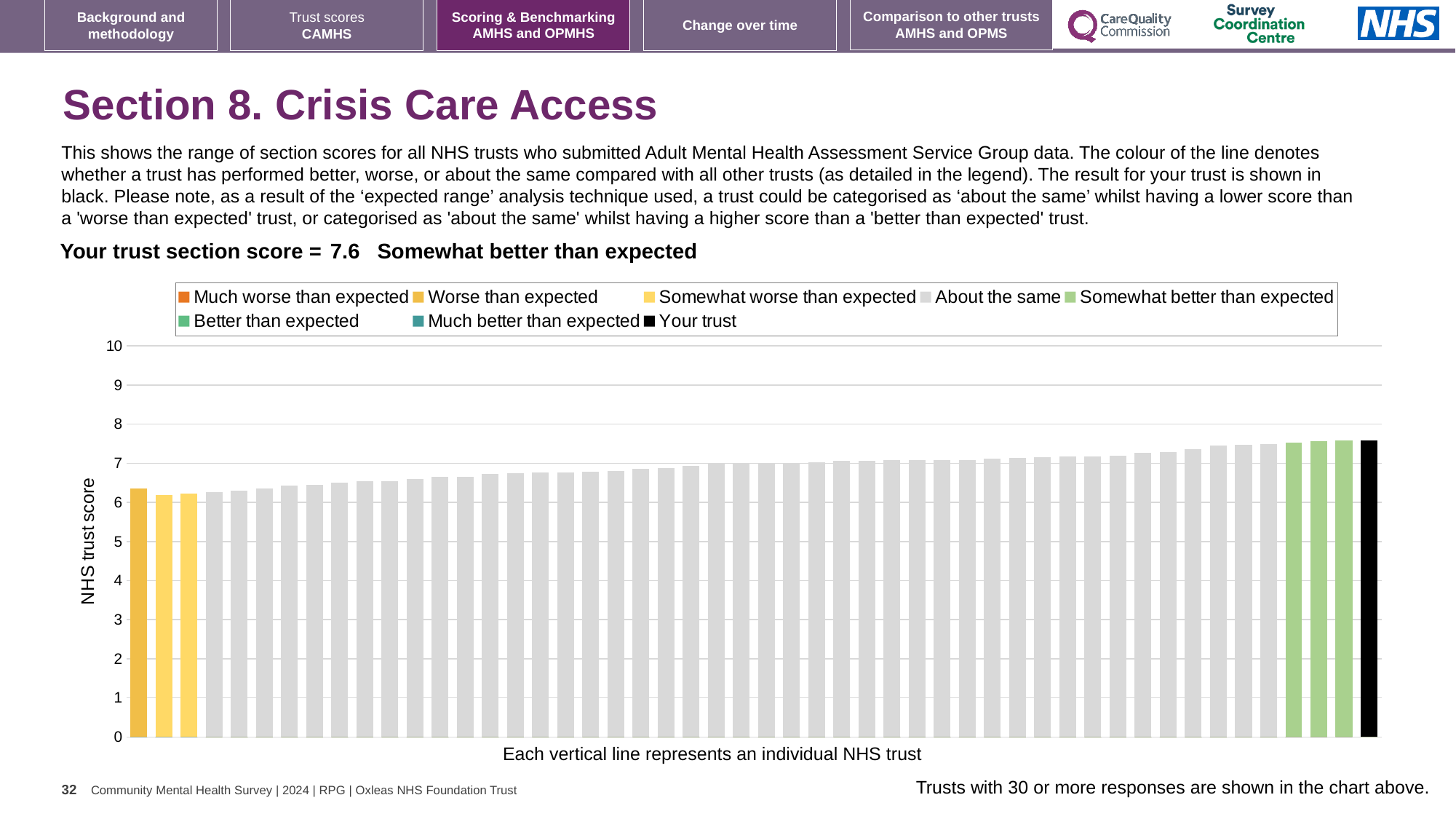
What kind of chart is shown on the slide? bar chart What colour is the bar representing your trust? black What is the label on the vertical axis of the chart? NHS trust score Do the bar values rise or fall from left to right along the x axis? rise Is the value of the black 'Your trust' bar greater or less than 8? less What is the section score for your trust shown on the slide? 7.6 Is the value of the leftmost bar greater or less than 7? less Which is larger: the value of the black 'Your trust' bar or the value of the leftmost bar? Your trust How many bars are coloured green (somewhat better than expected)? 3 Is the value of the leftmost bar greater or less than 6? greater How many entries does the chart legend list? 8